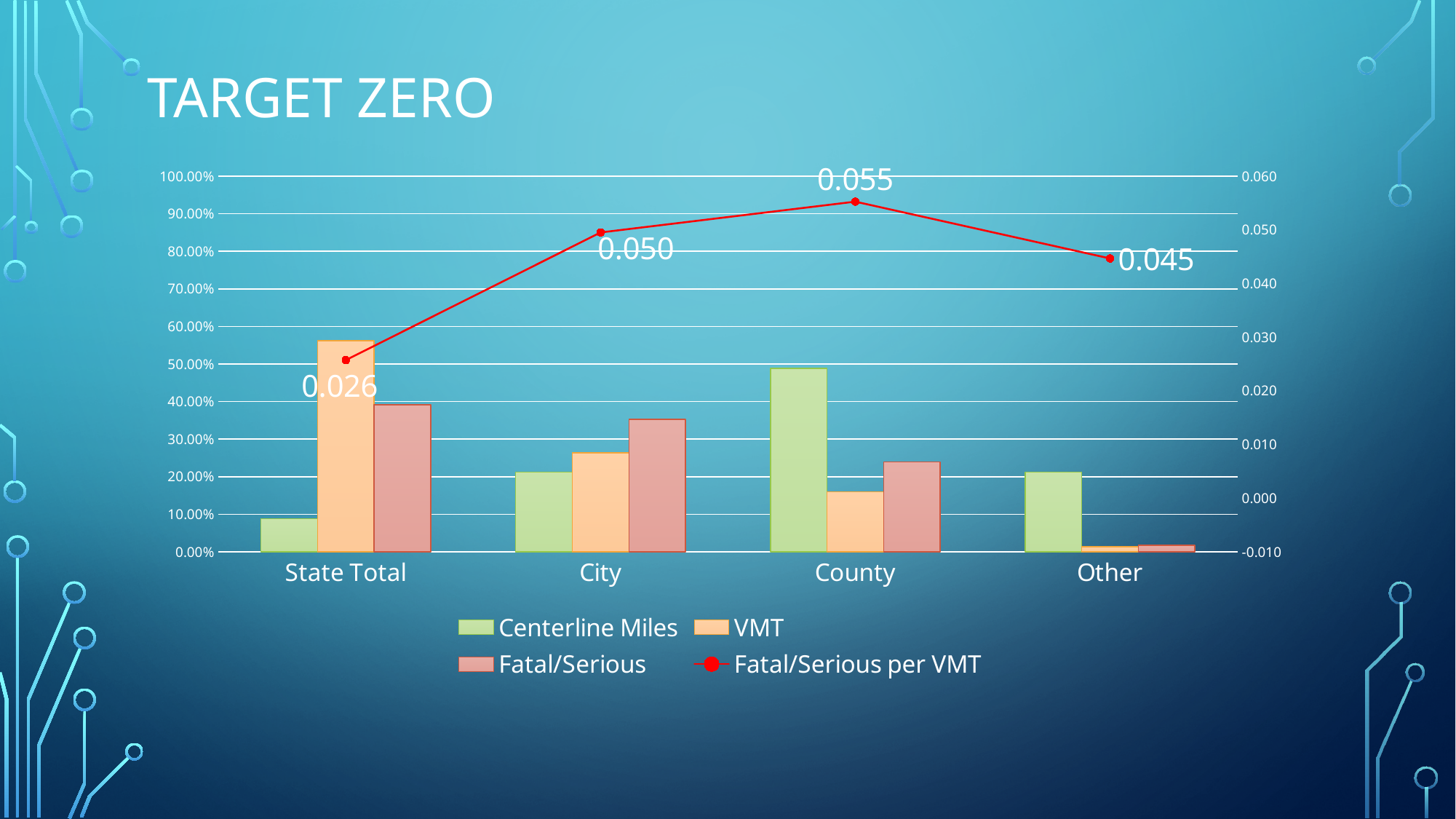
How many categories are shown on the x axis? 4 Which category has the tallest VMT bar? State Total How many series does the legend list? 4 What is the Fatal/Serious per VMT value for State Total? 0.026 What is the Fatal/Serious per VMT value for County? 0.055 Which category has the highest Fatal/Serious per VMT value? County Is the Centerline Miles value for County greater or less than 40.00%? greater Is the VMT value for State Total greater or less than 50.00%? greater What is the Fatal/Serious per VMT value for Other? 0.045 What is the difference between the Fatal/Serious per VMT values for County and State Total? 0.029 Which category has the lowest Fatal/Serious per VMT value? State Total Which has a larger Fatal/Serious per VMT value, City or Other? City